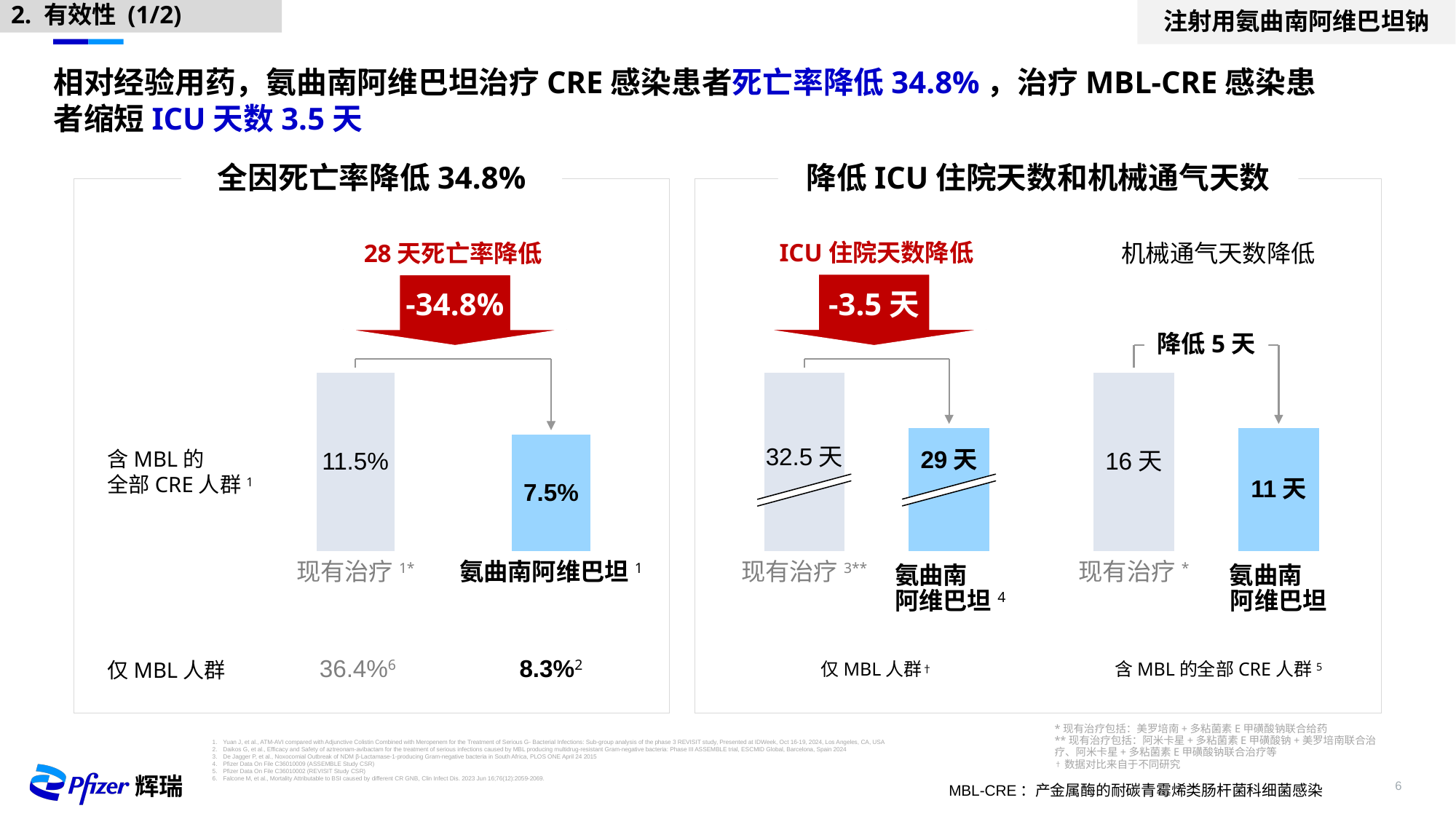
在“降低 ICU 住院天数和机械通气天数”图中，机械通气天数现有治疗与氨曲南阿维巴坦相差多少？ 5 天 在“降低 ICU 住院天数和机械通气天数”图中，氨曲南阿维巴坦组的 ICU 住院天数是多少？ 29 天 在“全因死亡率降低 34.8%”图中，氨曲南阿维巴坦组的 28 天死亡率是多少？ 7.5% 在“全因死亡率降低 34.8%”图中，现有治疗与氨曲南阿维巴坦哪一组的死亡率更高？ 现有治疗 在“降低 ICU 住院天数和机械通气天数”图中，现有治疗与氨曲南阿维巴坦的 ICU 住院天数相差多少？ 3.5 天 在“降低 ICU 住院天数和机械通气天数”图中，现有治疗组的机械通气天数是多少？ 16 天 在“降低 ICU 住院天数和机械通气天数”图中，氨曲南阿维巴坦组的机械通气天数是多少？ 11 天 在“降低 ICU 住院天数和机械通气天数”图中，现有治疗组的 ICU 住院天数是多少？ 32.5 天 在“全因死亡率降低 34.8%”图中，仅 MBL 人群的现有治疗死亡率是多少？ 36.4% “全因死亡率降低 34.8%”图是什么类型的图表？ 柱状图（条形图） 在“全因死亡率降低 34.8%”图中，现有治疗组的 28 天死亡率是多少？ 11.5% 在“全因死亡率降低 34.8%”图中，仅 MBL 人群的氨曲南阿维巴坦死亡率是多少？ 8.3%